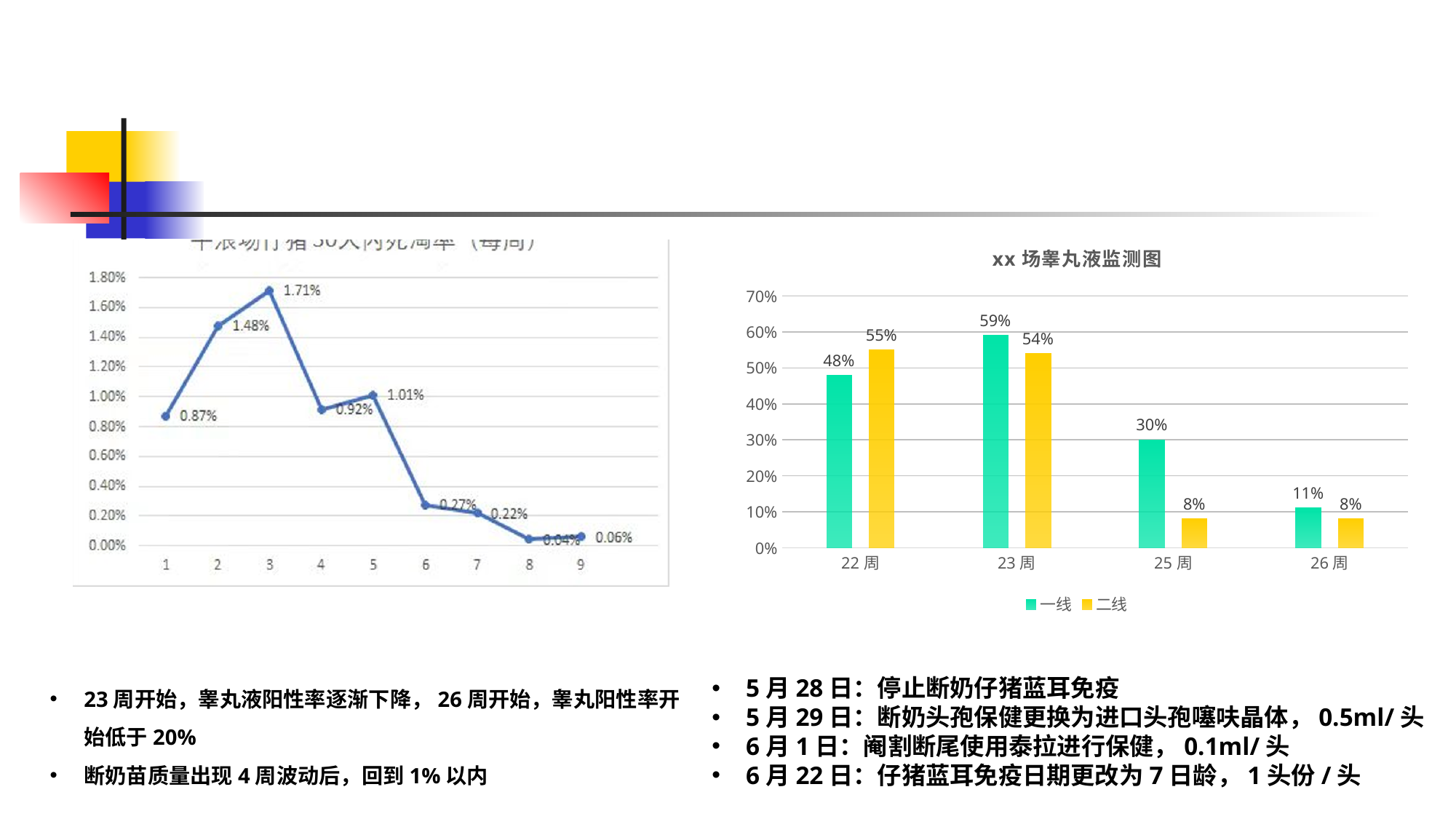
In the chart titled xx 场睾丸液监测图, what is the difference between 一线 and 二线 for 25 周? 22% On the left line chart, at which x value is the plotted value highest? 3 On the left line chart, what is the value at x = 3? 1.71% On the left line chart, what is the difference between the values at x = 2 and x = 1? 0.61% In the chart titled xx 场睾丸液监测图, what is the value of 一线 for 23 周? 59% In the chart titled xx 场睾丸液监测图, what is the value of 二线 for 22 周? 55% What kind of chart is the chart titled xx 场睾丸液监测图? bar chart In the chart titled xx 场睾丸液监测图, which is larger for 22 周, 一线 or 二线? 二线 In the chart titled xx 场睾丸液监测图, how many series does the legend list? 2 On the left line chart, at which x value is the plotted value lowest? 8 On the left line chart, what is the value at x = 6? 0.27% On the left line chart, how many data points are plotted? 9